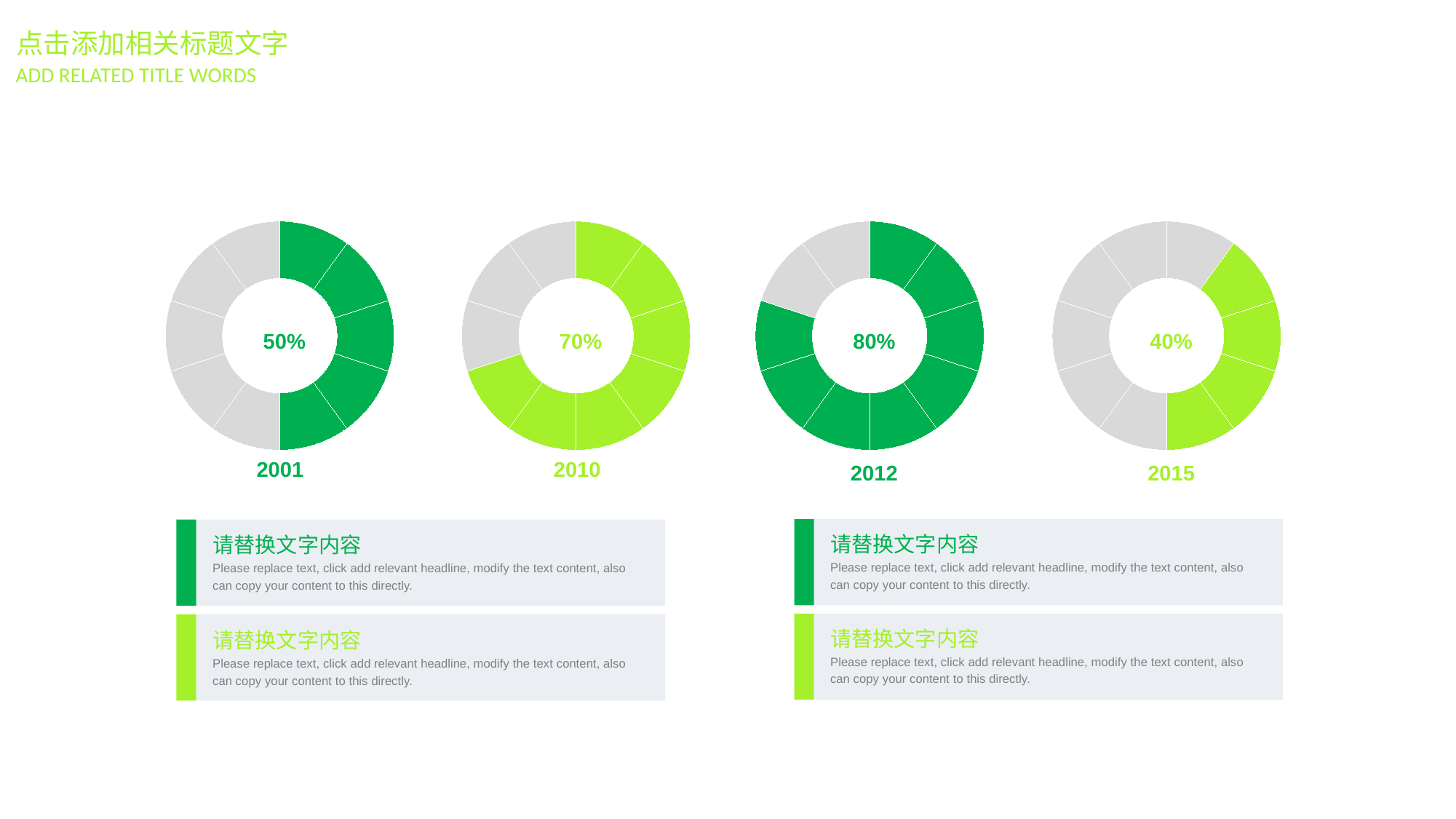
What kind of chart is used for each of the four years on the slide? Donut chart In the donut chart labelled 2015, what percentage is shown in the centre? 40% Across the four donut charts, which year shows the lowest percentage? 2015 What colour is the filled portion of the donut chart labelled 2010? Light green In the donut chart labelled 2001, what percentage is shown in the centre? 50% How many donut charts are on the slide? 4 Which shows a larger percentage, the 2001 donut chart or the 2010 donut chart? 2010 In the donut chart labelled 2015, what share of the ring is filled with colour? 40% In the donut chart labelled 2012, what percentage is shown in the centre? 80% What is the difference between the percentage shown for 2012 and the percentage shown for 2015? 40% Across the four donut charts, which year shows the highest percentage? 2012 In the donut chart labelled 2010, what percentage is shown in the centre? 70%